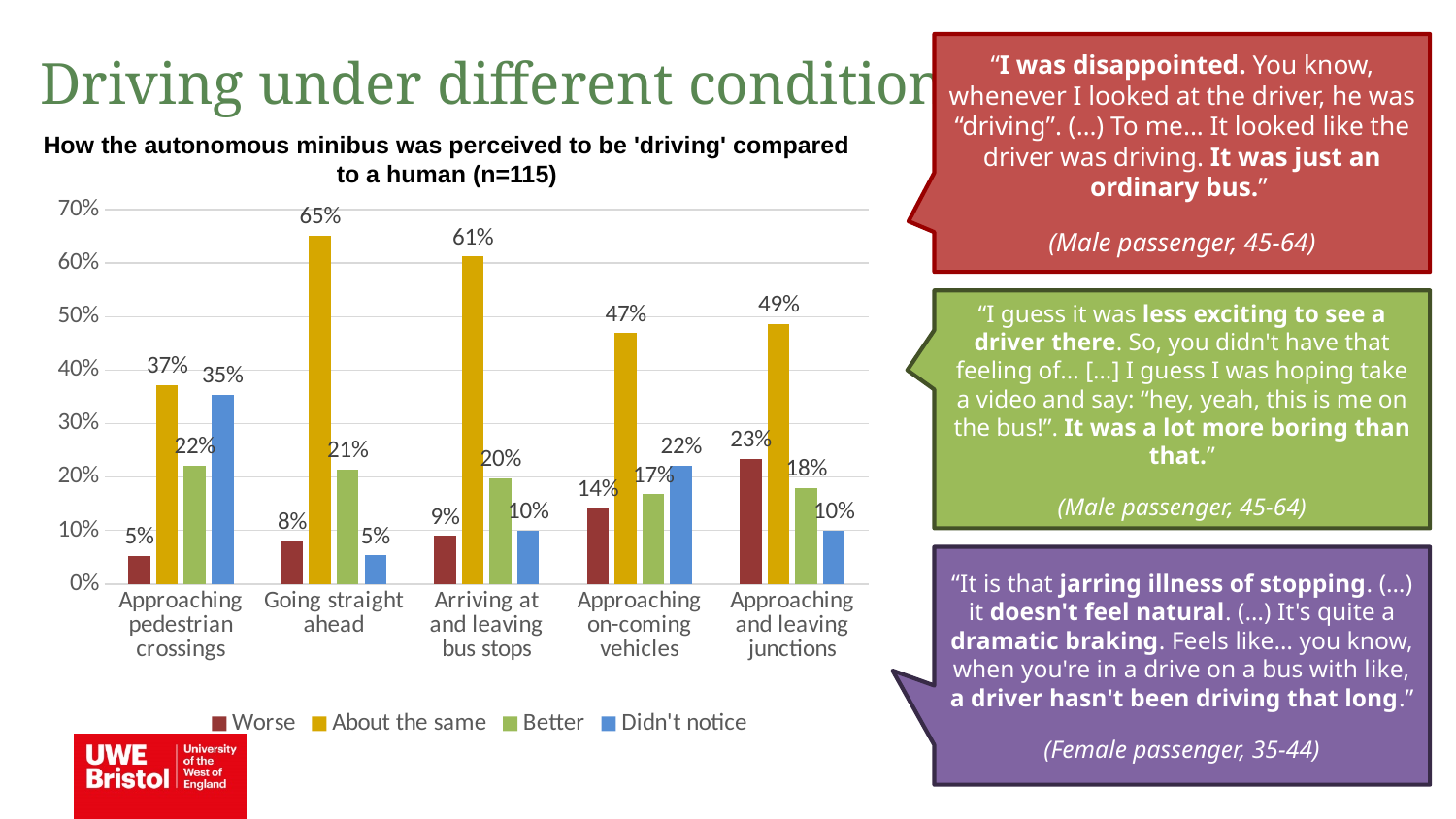
How many series does the legend list? 4 Does the 'Worse' share rise or fall across the categories from left to right? Rise What percentage said the minibus drove 'About the same' as a human when going straight ahead? 65% In which condition was the 'About the same' share highest? Going straight ahead How many driving conditions (categories) are shown on the x axis? 5 What kind of chart is shown on the slide? Bar chart What is the sample size (n) stated in the chart title? 115 What is the difference between the 'About the same' share for going straight ahead and for approaching on-coming vehicles? 18 percentage points In which condition was the 'Worse' share lowest? Approaching pedestrian crossings What percentage said 'Worse' for approaching and leaving junctions? 23% For approaching pedestrian crossings, which is larger: the 'About the same' share or the 'Didn't notice' share? About the same What percentage said 'Didn't notice' for approaching pedestrian crossings? 35%